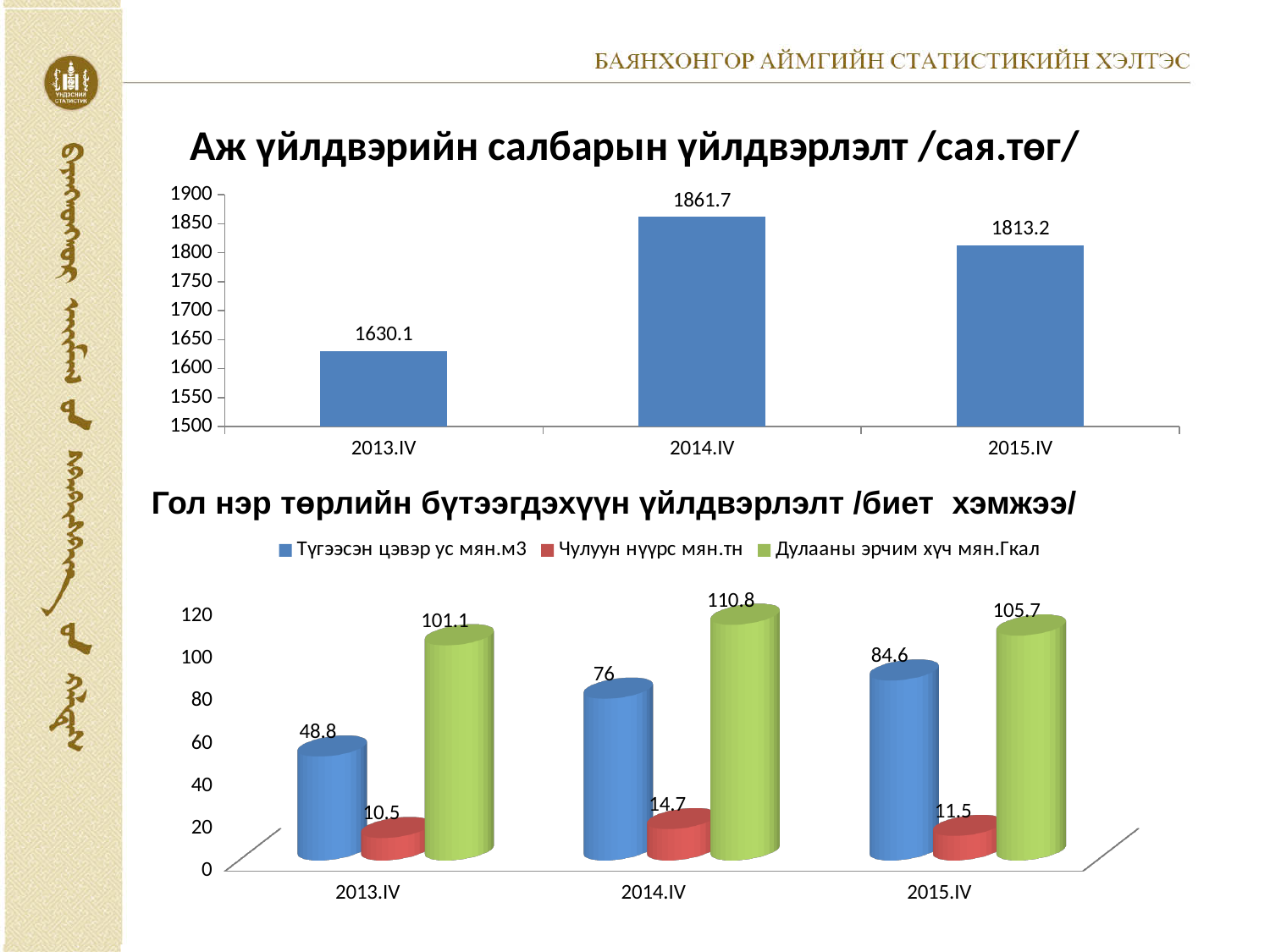
In the bottom chart (Гол нэр төрлийн бүтээгдэхүүн үйлдвэрлэлт), how many series does the legend list? 3 In the bottom chart (Гол нэр төрлийн бүтээгдэхүүн үйлдвэрлэлт), which is larger for 2013.IV: Түгээсэн цэвэр ус мян.м3 or Чулуун нүүрс мян.тн? Түгээсэн цэвэр ус мян.м3 In the top chart (Аж үйлдвэрийн салбарын үйлдвэрлэлт), which period has the lowest value? 2013.IV In the bottom chart (Гол нэр төрлийн бүтээгдэхүүн үйлдвэрлэлт), what is the value of Түгээсэн цэвэр ус мян.м3 for 2015.IV? 84.6 In the bottom chart (Гол нэр төрлийн бүтээгдэхүүн үйлдвэрлэлт), what is the value of Чулуун нүүрс мян.тн for 2014.IV? 14.7 In the bottom chart (Гол нэр төрлийн бүтээгдэхүүн үйлдвэрлэлт), does Түгээсэн цэвэр ус мян.м3 rise or fall from 2013.IV to 2015.IV? Rise In the top chart (Аж үйлдвэрийн салбарын үйлдвэрлэлт), what is the value for 2014.IV? 1861.7 In the bottom chart (Гол нэр төрлийн бүтээгдэхүүн үйлдвэрлэлт), in which period is Дулааны эрчим хүч мян.Гкал highest? 2014.IV In the top chart (Аж үйлдвэрийн салбарын үйлдвэрлэлт), how many periods are shown on the x axis? 3 What kind of chart is the top chart (Аж үйлдвэрийн салбарын үйлдвэрлэлт)? Bar chart In the top chart (Аж үйлдвэрийн салбарын үйлдвэрлэлт), what is the difference between the 2014.IV and 2013.IV values? 231.6 In the bottom chart (Гол нэр төрлийн бүтээгдэхүүн үйлдвэрлэлт), what colour are the bars for Дулааны эрчим хүч мян.Гкал? Green